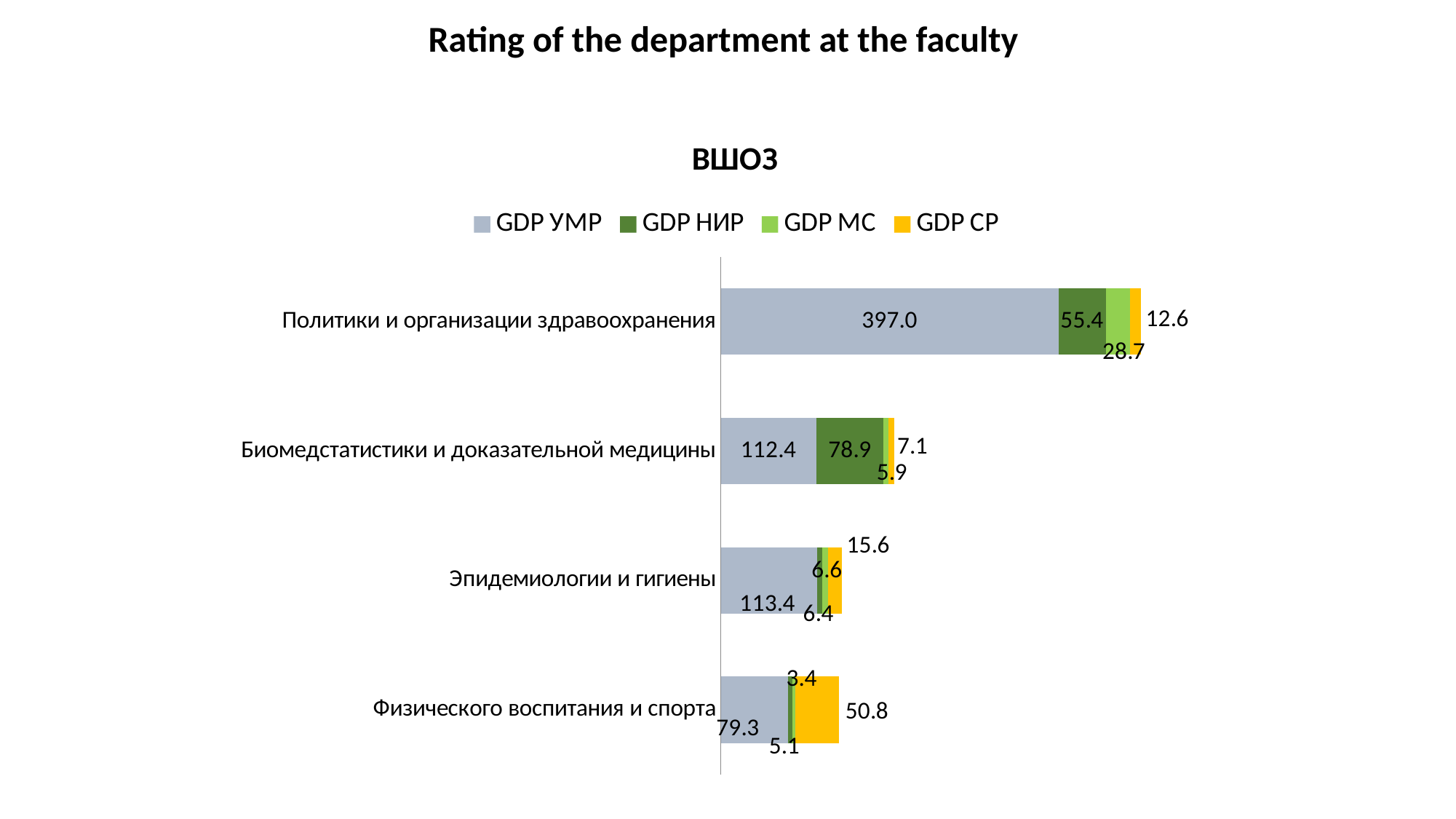
What is the difference between the GDP УМР values of Политики и организации здравоохранения and Биомедстатистики и доказательной медицины? 284.6 Which department has the lowest GDP УМР value? Физического воспитания и спорта How many departments (categories) are shown in the chart? 4 What is the total of the stacked bar for Биомедстатистики и доказательной медицины? 204.3 What type of chart is shown on the slide? Stacked bar chart What is the GDP УМР value for Политики и организации здравоохранения? 397.0 What is the GDP НИР value for Биомедстатистики и доказательной медицины? 78.9 What is the GDP СР value for Физического воспитания и спорта? 50.8 Which department has the highest GDP УМР value? Политики и организации здравоохранения Which is larger: the GDP СР value for Физического воспитания и спорта or for Эпидемиологии и гигиены? Физического воспитания и спорта What is the GDP МС value for Политики и организации здравоохранения? 28.7 How many series does the legend list? 4